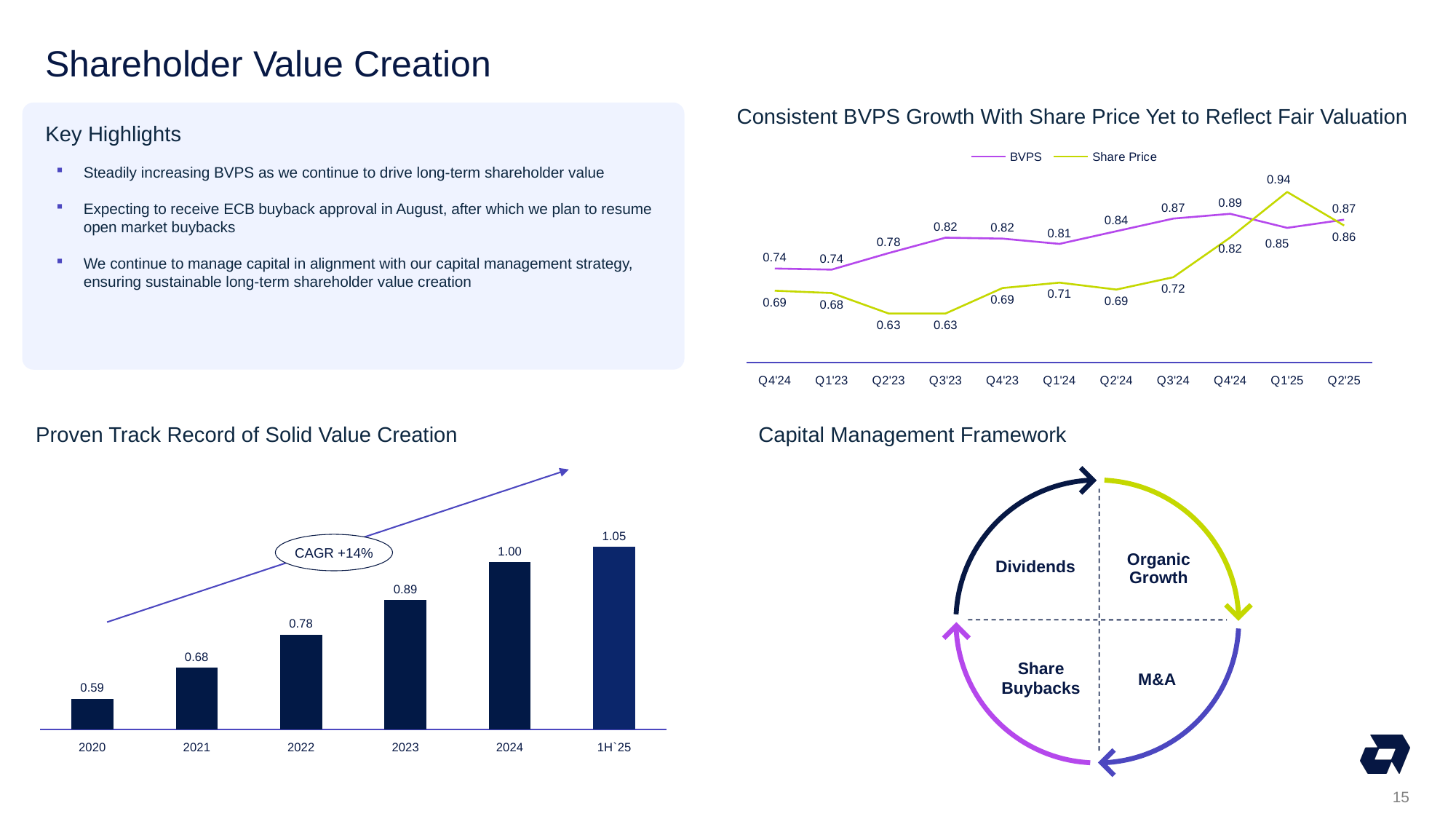
What kind of chart is 'Proven Track Record of Solid Value Creation'? Bar chart In the 'Consistent BVPS Growth With Share Price Yet to Reflect Fair Valuation' chart, what is the difference between BVPS and Share Price at Q3'23? 0.19 In the 'Proven Track Record of Solid Value Creation' chart, how many bars are plotted? 6 In the 'Proven Track Record of Solid Value Creation' chart, do the values rise or fall from 2020 to 1H`25? Rise In the 'Consistent BVPS Growth With Share Price Yet to Reflect Fair Valuation' chart, what is the Share Price value for Q1'25? 0.94 In the 'Consistent BVPS Growth With Share Price Yet to Reflect Fair Valuation' chart, how many series does the legend list? 2 In the 'Consistent BVPS Growth With Share Price Yet to Reflect Fair Valuation' chart, which is larger at Q2'23: BVPS or Share Price? BVPS In the 'Proven Track Record of Solid Value Creation' chart, what CAGR is shown in the callout? CAGR +14% In the 'Proven Track Record of Solid Value Creation' chart, which category has the lowest value? 2020 In the 'Proven Track Record of Solid Value Creation' chart, what is the difference between the values for 2024 and 2020? 0.41 In the 'Consistent BVPS Growth With Share Price Yet to Reflect Fair Valuation' chart, what is the BVPS value for Q3'24? 0.87 In the 'Proven Track Record of Solid Value Creation' chart, what is the value for 2023? 0.89